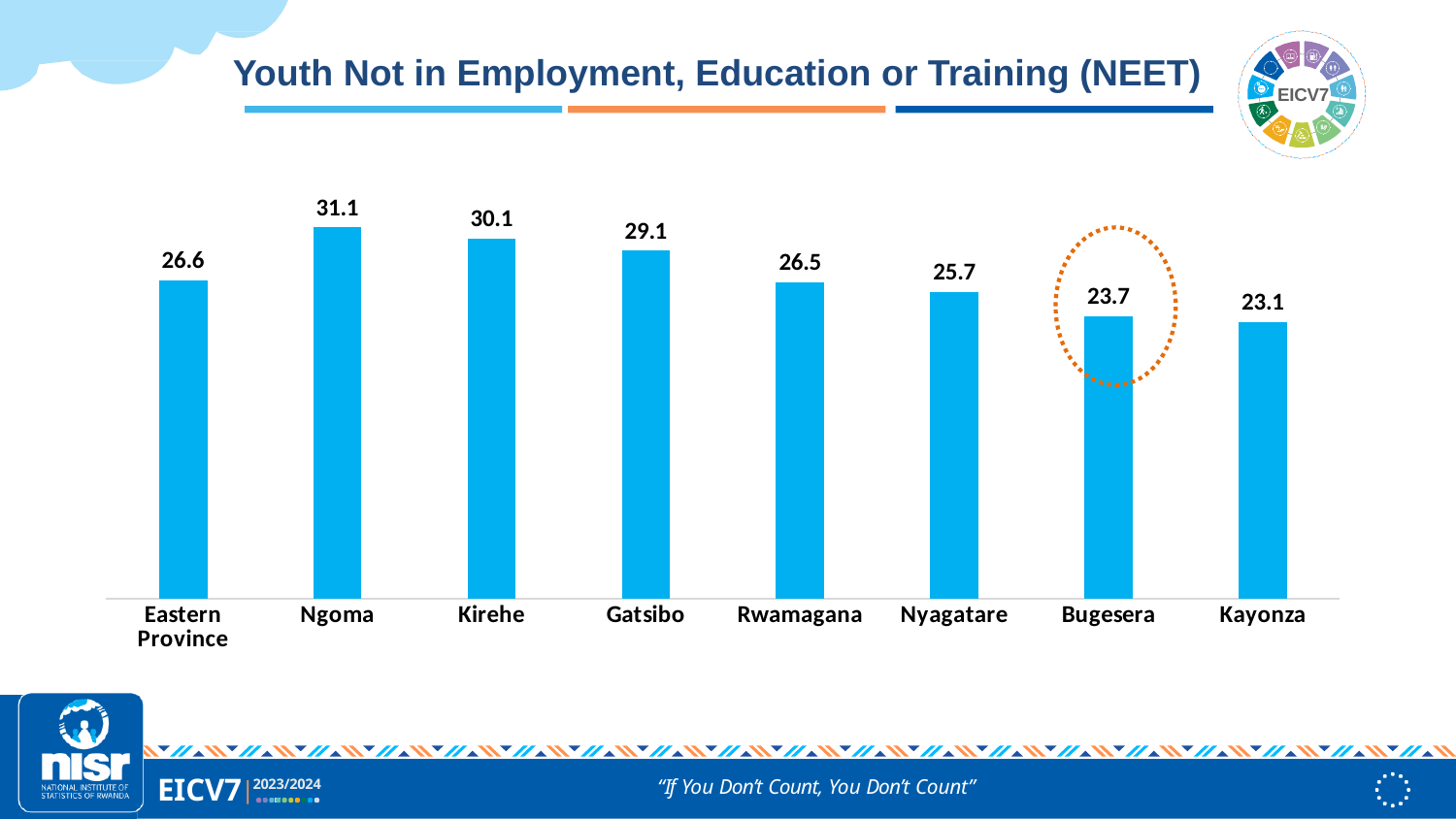
Which has a higher NEET value, Rwamagana or Nyagatare? Rwamagana What is the NEET value for Bugesera? 23.7 Which category's bar is highlighted with a dotted orange circle? Bugesera Which category has the highest NEET value? Ngoma What kind of chart is shown on the slide? Bar chart How many categories are shown on the x axis of the chart? 8 What is the NEET value for Eastern Province? 26.6 What is the difference between the NEET values for Ngoma and Kayonza? 8.0 Which category has the lowest NEET value? Kayonza What is the difference between the NEET values for Kirehe and Gatsibo? 1.0 Which has a higher NEET value, Kirehe or Bugesera? Kirehe What is the NEET value for Ngoma? 31.1